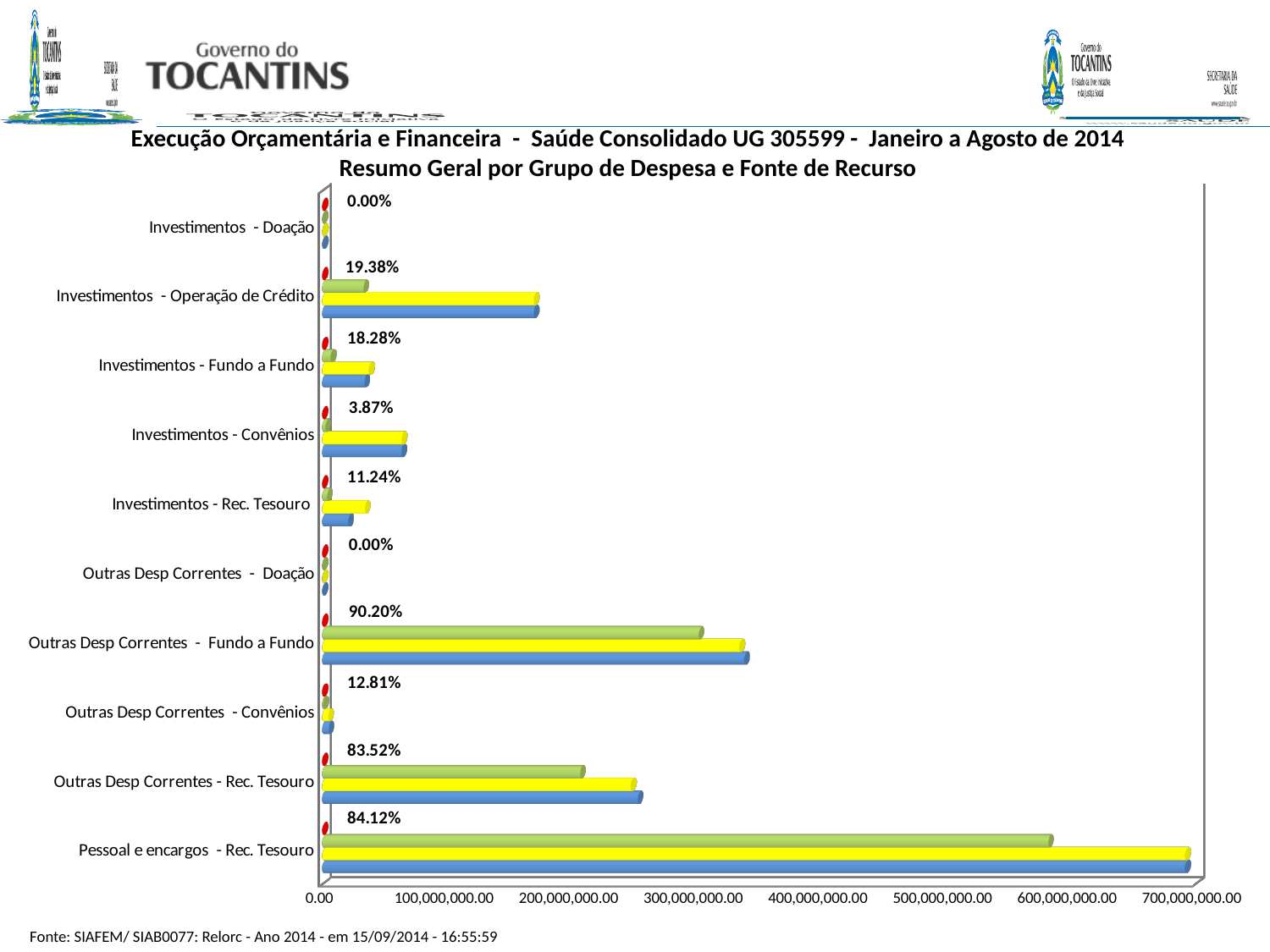
What is the title of the chart? Resumo Geral por Grupo de Despesa e Fonte de Recurso What percentage is shown for Pessoal e encargos - Rec. Tesouro? 84.12% What percentage is shown for Investimentos - Operação de Crédito? 19.38% Which has the larger percentage label: Pessoal e encargos - Rec. Tesouro or Outras Desp Correntes - Rec. Tesouro? Pessoal e encargos - Rec. Tesouro Is the blue bar for Investimentos - Operação de Crédito greater or less than 200,000,000.00? less How many categories are shown on the chart? 10 Which category has the highest percentage label? Outras Desp Correntes - Fundo a Fundo What percentage is shown for Outras Desp Correntes - Fundo a Fundo? 90.20% Is the blue bar for Pessoal e encargos - Rec. Tesouro greater or less than 600,000,000.00? greater What kind of chart is shown on the slide? Bar chart What is the difference between the percentage labels for Outras Desp Correntes - Fundo a Fundo and Outras Desp Correntes - Rec. Tesouro? 6.68%